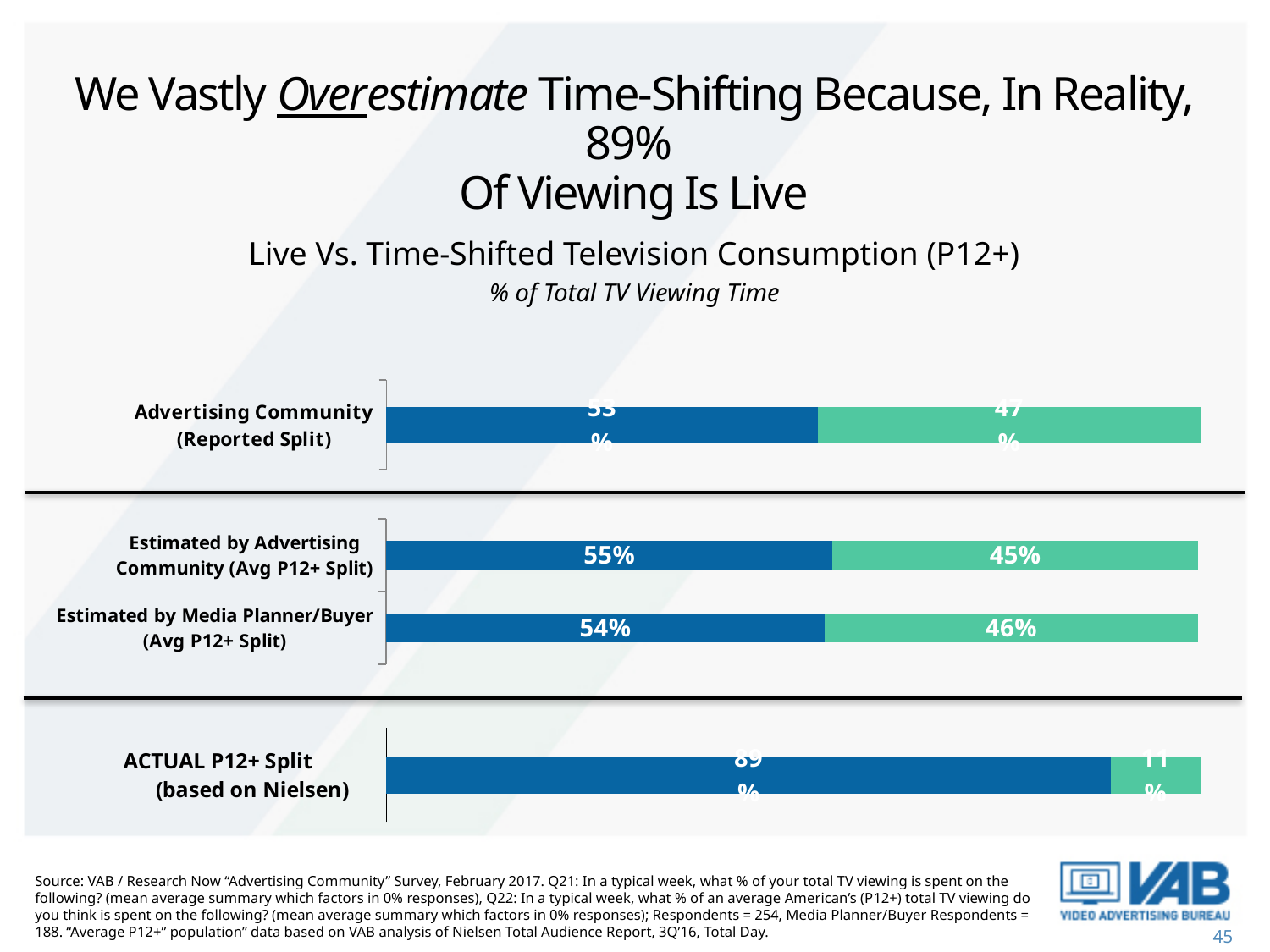
What kind of chart is shown on the slide? Stacked bar chart What is the value of the green segment for 'Estimated by Media Planner/Buyer (Avg P12+ Split)'? 46% What is the value of the dark blue segment for 'ACTUAL P12+ Split (based on Nielsen)'? 89% Which is larger: the green segment for 'Estimated by Advertising Community (Avg P12+ Split)' or the green segment for 'ACTUAL P12+ Split (based on Nielsen)'? Estimated by Advertising Community (Avg P12+ Split) Which category has the smallest green segment? ACTUAL P12+ Split (based on Nielsen) What is the difference between the dark blue segment for 'ACTUAL P12+ Split (based on Nielsen)' and the dark blue segment for 'Estimated by Advertising Community (Avg P12+ Split)'? 34% What is the subtitle shown in italics beneath the chart title 'Live Vs. Time-Shifted Television Consumption (P12+)'? % of Total TV Viewing Time How many category bars are shown on the slide in total? 4 Which category has the largest dark blue segment? ACTUAL P12+ Split (based on Nielsen) What is the value of the dark blue segment for 'Estimated by Advertising Community (Avg P12+ Split)'? 55% What is the value of the green segment for 'ACTUAL P12+ Split (based on Nielsen)'? 11% What is the total of the two segments in the 'Estimated by Media Planner/Buyer (Avg P12+ Split)' bar? 100%